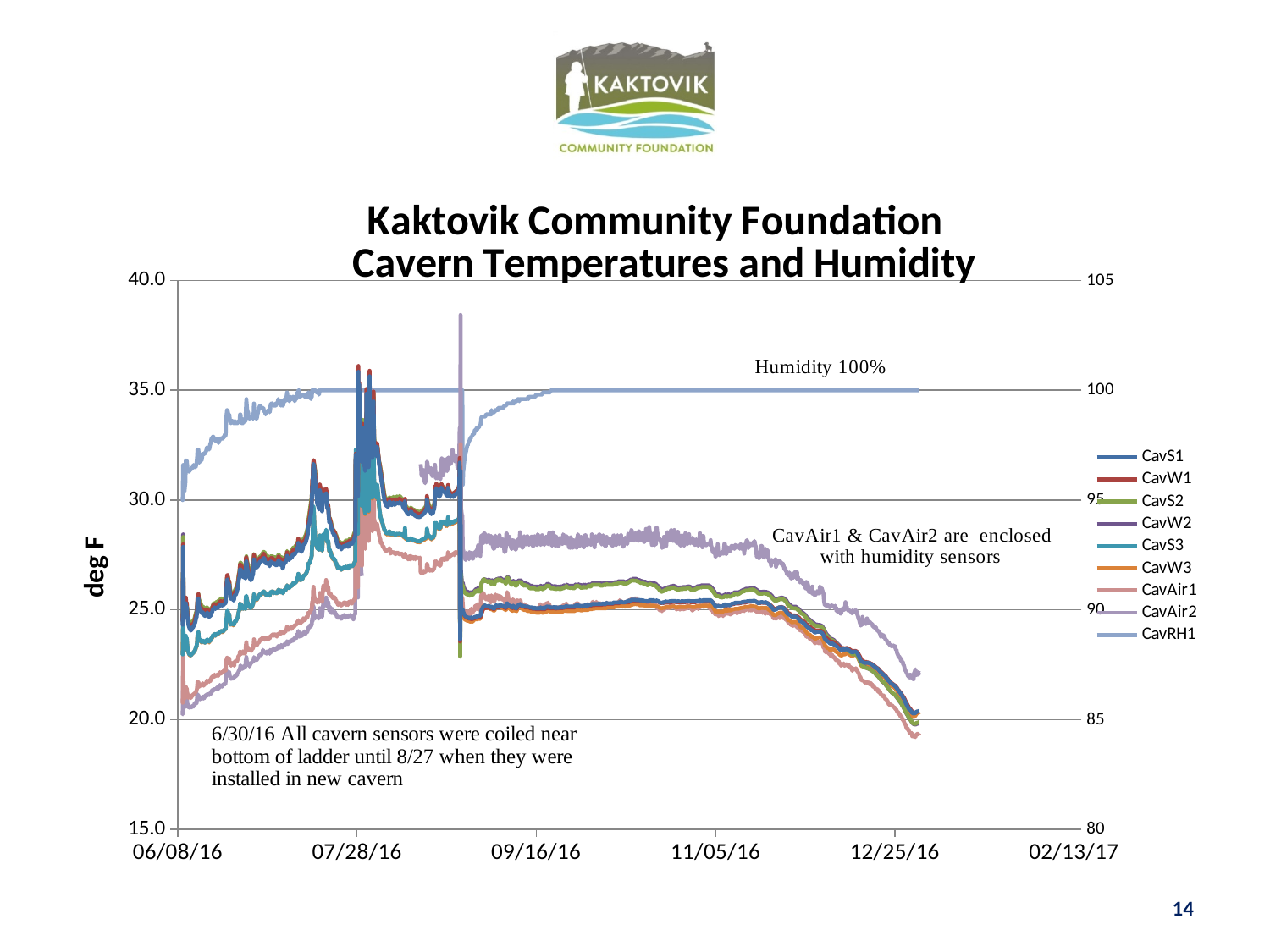
Is the value of CavAir1 at the start of the chart (06/08/16) greater or less than 25.0 deg F? less Is the value of CavAir2 around 10/15/16 greater or less than 25.0 deg F? greater What is the title of the chart? Kaktovik Community Foundation Cavern Temperatures and Humidity Do the cavern temperature series rise or fall between 11/05/16 and the end of the data? fall Is the CavRH1 value around 07/28/16 greater or less than 95 on the right axis? greater How many series does the chart legend list? 9 Around 10/15/16, which is higher: CavAir2 or CavS1? CavAir2 What kind of chart is shown on the slide? line chart How many date labels are shown along the x-axis? 6 What is the label on the left y-axis of the chart? deg F Among the temperature series, which one has the highest values around 10/15/16? CavAir2